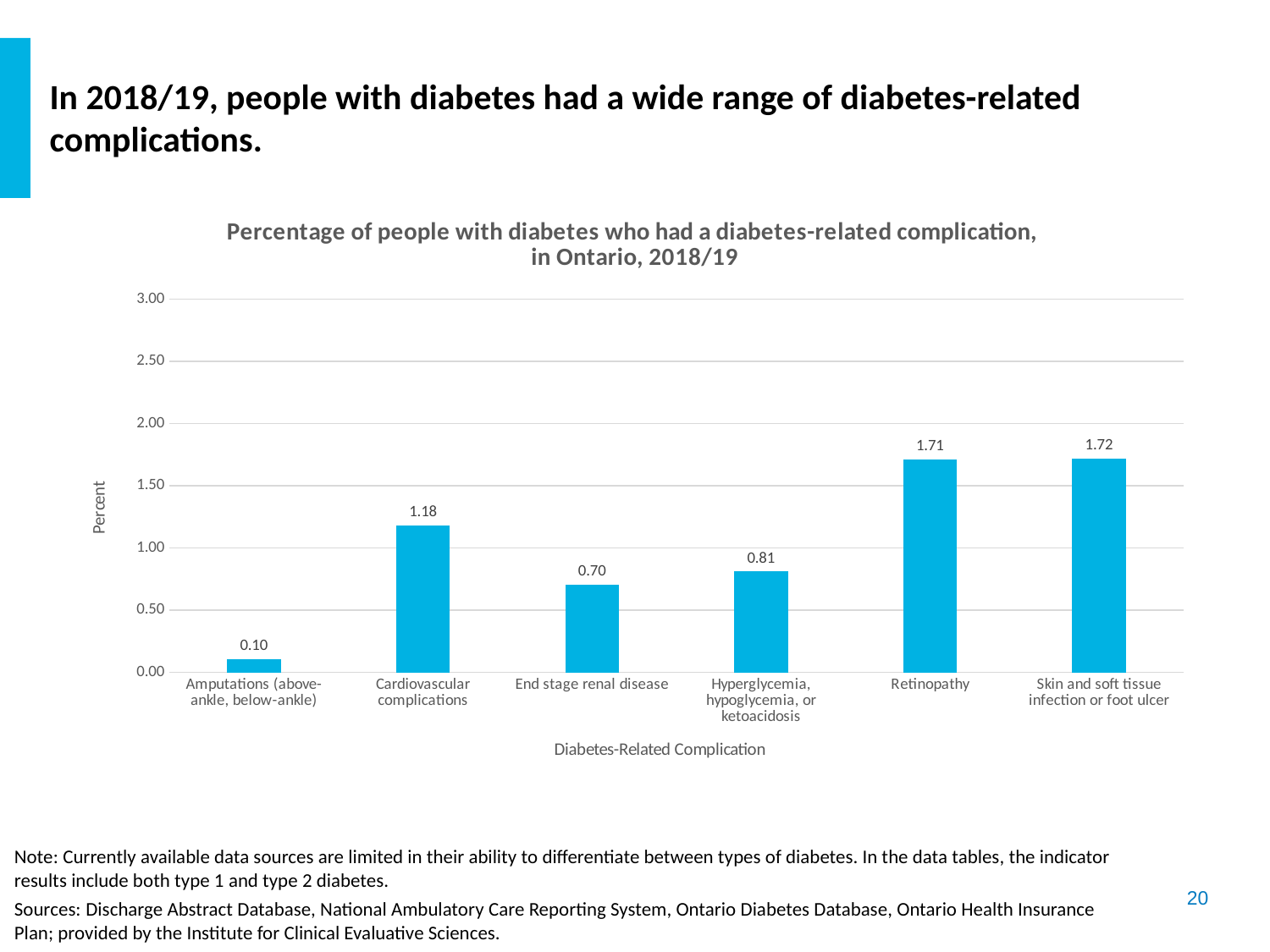
What is the value for End stage renal disease? 0.70 What is the difference between the values for Retinopathy and Hyperglycemia, hypoglycemia, or ketoacidosis? 0.90 Which is larger, the value for Hyperglycemia, hypoglycemia, or ketoacidosis or the value for End stage renal disease? Hyperglycemia, hypoglycemia, or ketoacidosis What is the value for Amputations (above-ankle, below-ankle)? 0.10 Which diabetes-related complication has the lowest percentage? Amputations (above-ankle, below-ankle) What is the value for Retinopathy? 1.71 What is the value for Cardiovascular complications? 1.18 Is the value for Cardiovascular complications greater or less than 1.00? greater What kind of chart is shown on the slide? Bar chart What is the label of the vertical axis of the chart? Percent How many diabetes-related complication categories are shown in the chart? 6 What is the difference between the values for Cardiovascular complications and End stage renal disease? 0.48